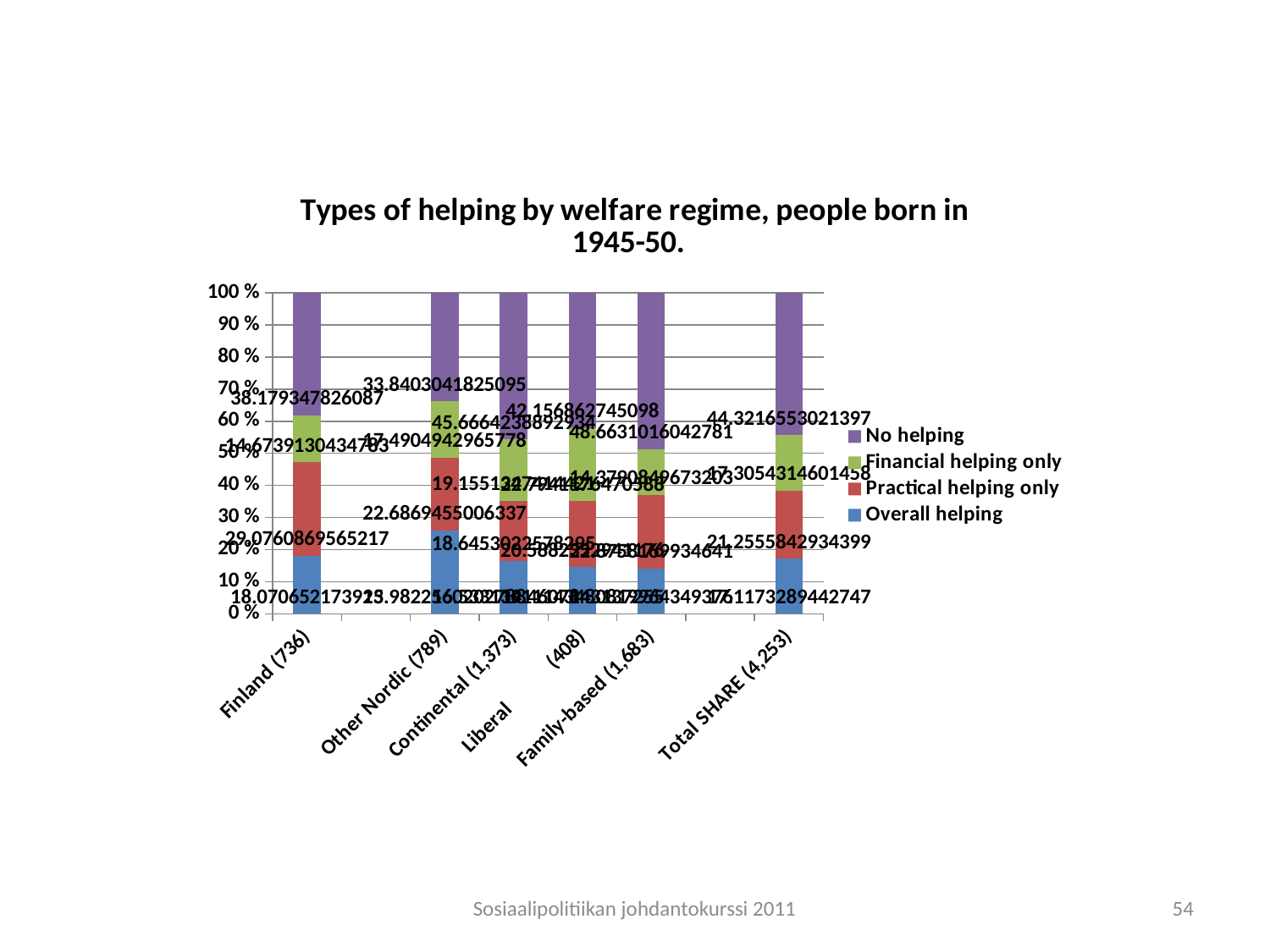
Which colour represents 'No helping' in the chart? Purple What is the title of the chart? Types of helping by welfare regime, people born in 1945-50. How many welfare regime categories are shown on the x axis? 6 Which category has the lowest 'No helping' share? Other Nordic (789) What kind of chart is shown on the slide? Stacked bar chart What is the 'Practical helping only' value for Other Nordic (789)? 22.6869455006337 How many series does the legend list? 4 Is the 'No helping' value for Family-based (1,683) greater or less than 40%? greater Which category has the largest 'Overall helping' share? Other Nordic (789) What is the 'No helping' value for Total SHARE (4,253)? 44.3216553021397 What is the 'No helping' value for Finland (736)? 38.179347826087 Is the 'Overall helping' value for Other Nordic (789) greater or less than 20%? greater